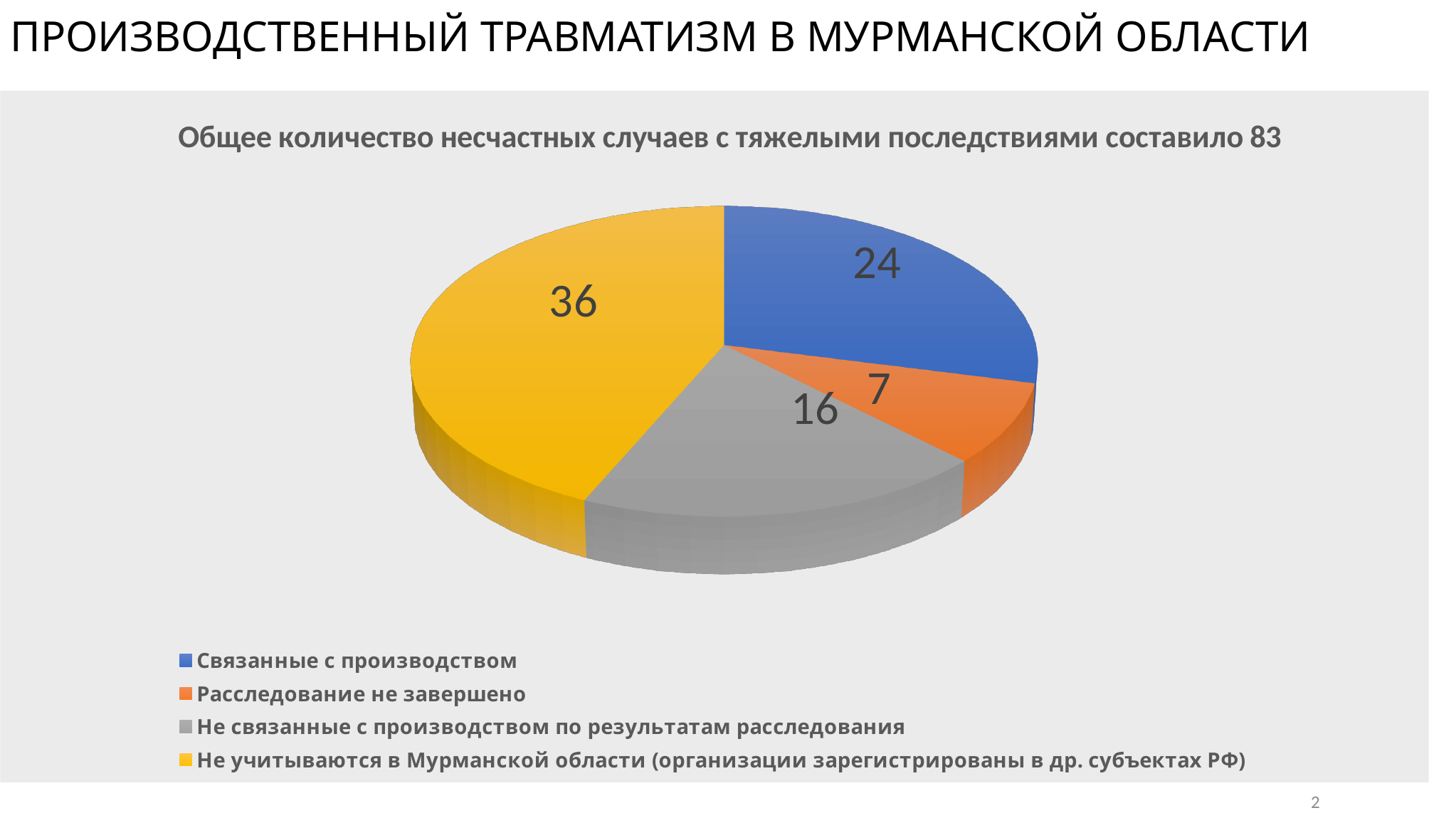
Which category has the largest slice of the pie? Не учитываются в Мурманской области (организации зарегистрированы в др. субъектах РФ) What is the value for "Не связанные с производством по результатам расследования"? 16 What total number of accidents with severe consequences does the chart title state? 83 What is the value for "Не учитываются в Мурманской области (организации зарегистрированы в др. субъектах РФ)"? 36 What is the value for "Расследование не завершено"? 7 Which is larger: the value for "Связанные с производством" or the value for "Не связанные с производством по результатам расследования"? Связанные с производством What is the value for "Связанные с производством"? 24 Which category has the smallest slice of the pie? Расследование не завершено What is the difference between the values for "Не учитываются в Мурманской области" and "Связанные с производством"? 12 How many categories does the legend list? 4 What kind of chart is shown on the slide? Pie chart What is the difference between the values for "Не связанные с производством по результатам расследования" and "Расследование не завершено"? 9